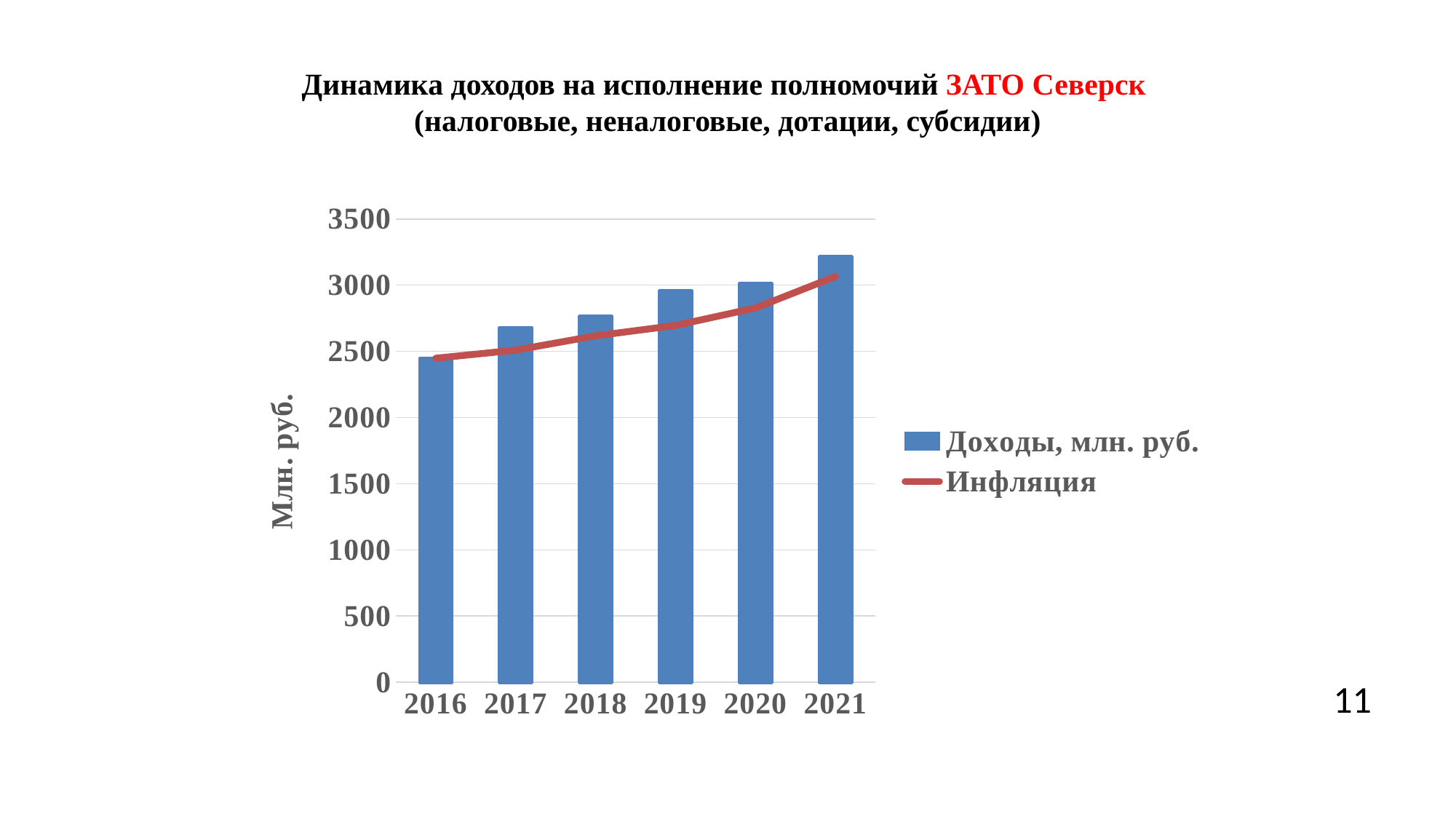
Which year has the larger Доходы bar, 2017 or 2019? 2019 Which year has the lowest bar for Доходы, млн. руб.? 2016 How many series does the legend list? 2 Is the Доходы value for 2017 greater or less than 2500? greater Which series is drawn as a red line in the chart? Инфляция Which year has the highest bar for Доходы, млн. руб.? 2021 Do the Доходы bars rise or fall from 2016 to 2021? rise Is the Доходы value for 2021 greater or less than 3000? greater How many years are shown on the x axis of the chart? 6 Is the Доходы value for 2018 greater or less than 3000? less What is the label on the vertical axis of the chart? Млн. руб. What kind of chart is shown on the slide? bar chart with a line